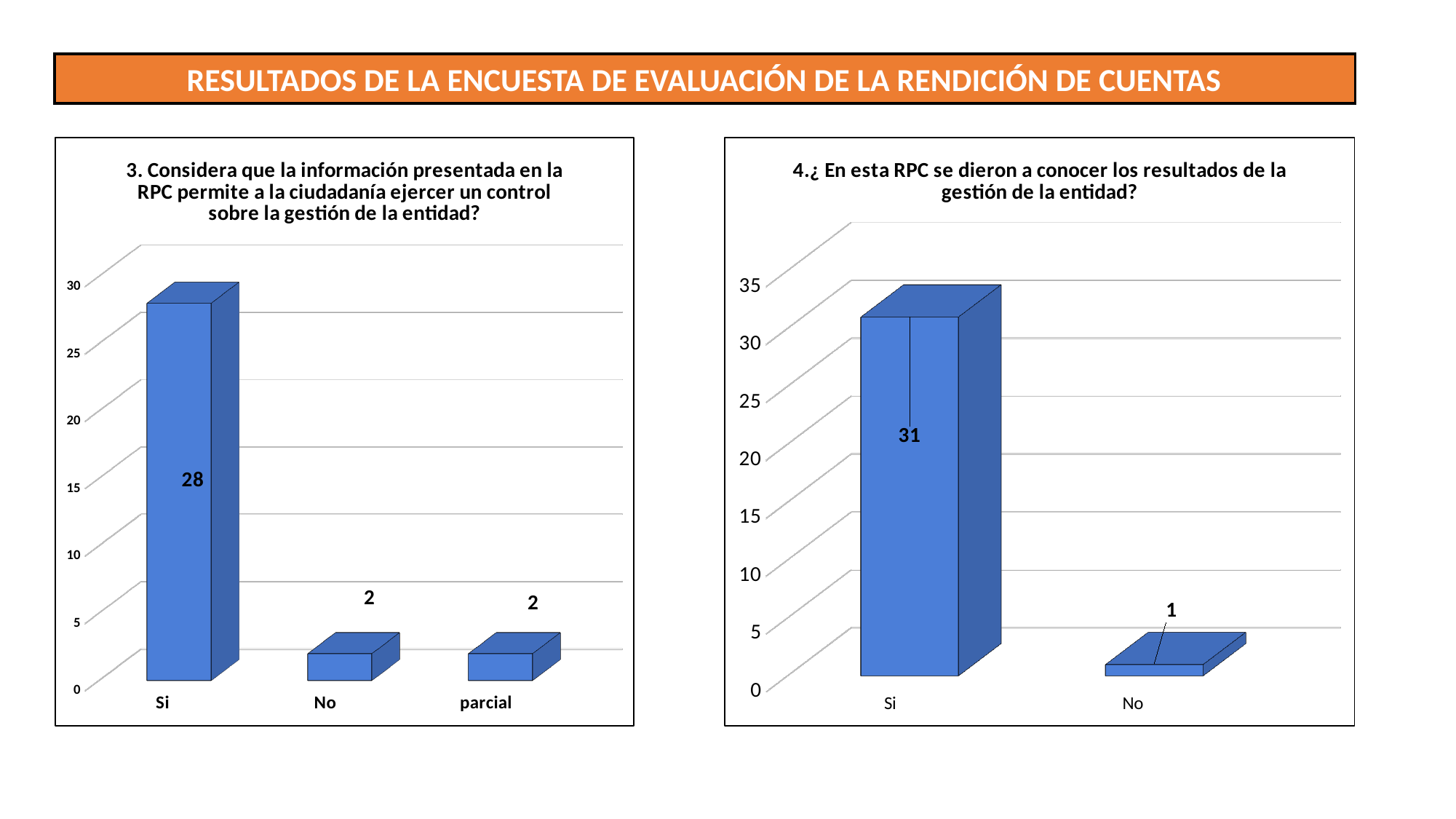
In the left chart (question 3), what is the value for 'Si'? 28 Which is larger: the value for 'Si' in the left chart (question 3) or the value for 'Si' in the right chart (question 4)? Right chart (question 4), 31 In the right chart (question 4), what is the value for 'Si'? 31 In the left chart (question 3), which category has the highest value? Si In the right chart (question 4), what is the value for 'No'? 1 In the right chart (question 4), how many categories are shown on the x axis? 2 In the left chart (question 3), what kind of chart is shown? Bar chart In the right chart (question 4), what is the difference between the values for 'Si' and 'No'? 30 In the left chart (question 3), what is the value for 'No'? 2 In the left chart (question 3), how many categories are shown on the x axis? 3 In the left chart (question 3), what is the difference between the values for 'Si' and 'parcial'? 26 In the right chart (question 4), which category has the lowest value? No